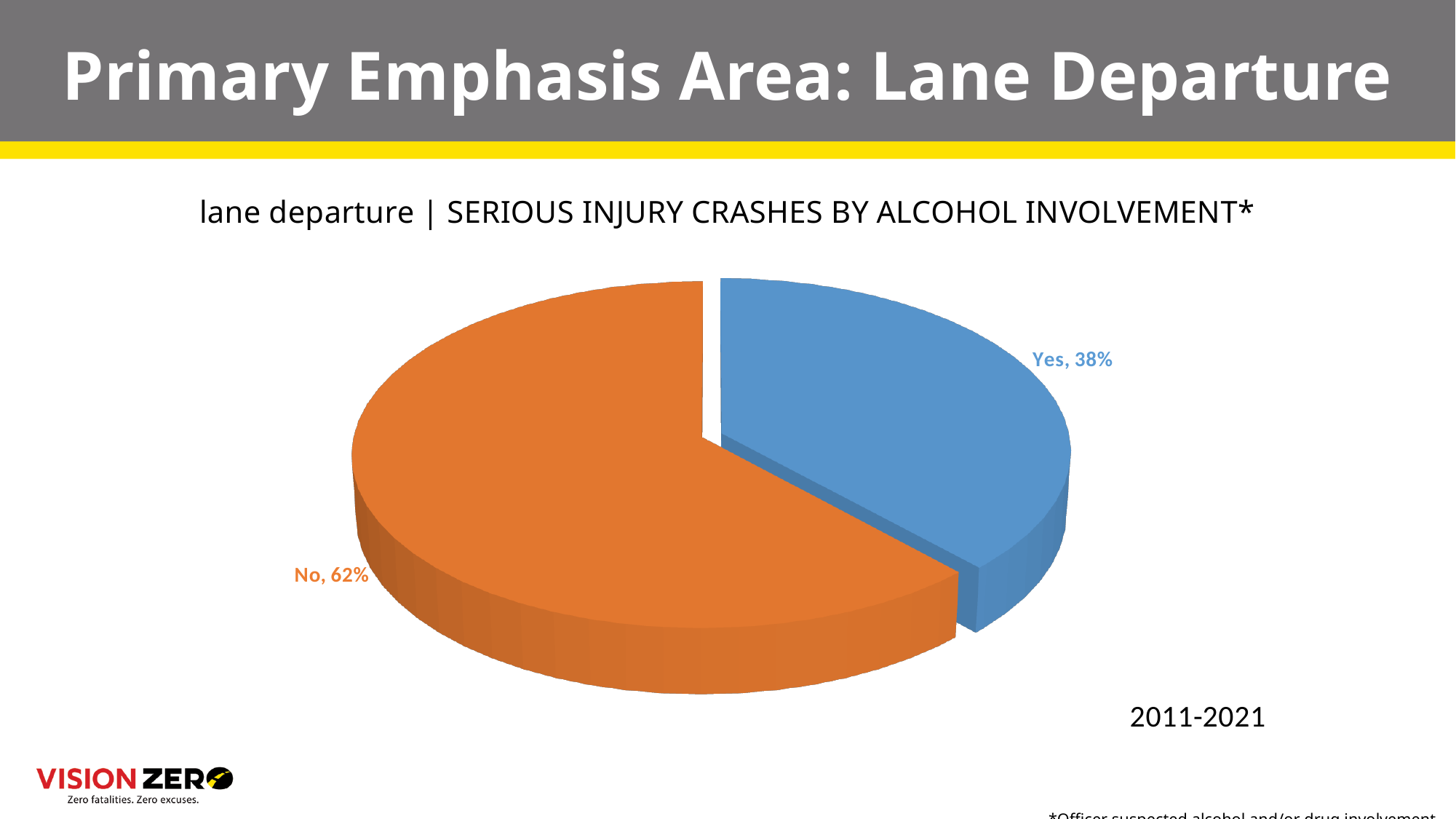
What share of lane departure serious injury crashes did not involve alcohol (No)? 62% What share of lane departure serious injury crashes involved alcohol (Yes)? 38% Which is larger, the Yes slice or the No slice? No Which slice of the pie is the largest? No What colour is the Yes slice? Blue How many slices does the pie chart have? 2 What kind of chart is shown on the slide? Pie chart What time period does the chart cover? 2011-2021 Which slice of the pie is the smallest? Yes What is the difference in percentage points between the No and Yes slices? 24 What is the title of the chart? lane departure | SERIOUS INJURY CRASHES BY ALCOHOL INVOLVEMENT*